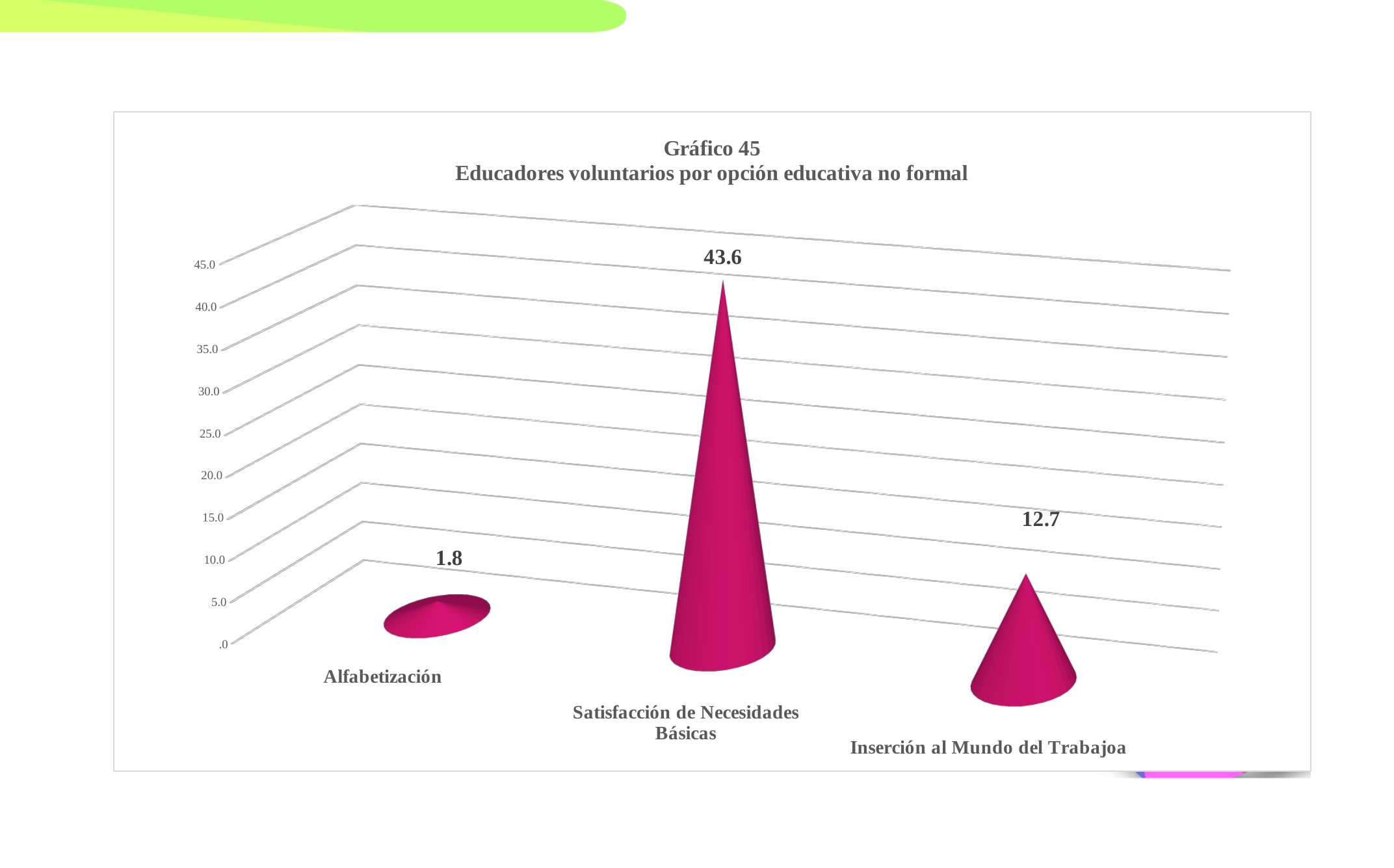
What is the difference between the values for Satisfacción de Necesidades Básicas and Inserción al Mundo del Trabajoa? 30.9 What is the value for Inserción al Mundo del Trabajoa? 12.7 Which category has the lowest value? Alfabetización What is the value for Satisfacción de Necesidades Básicas? 43.6 What is the difference between the values for Inserción al Mundo del Trabajoa and Alfabetización? 10.9 What is the value for Alfabetización? 1.8 What is the title of the chart? Gráfico 45 Educadores voluntarios por opción educativa no formal Is the value for Satisfacción de Necesidades Básicas greater or less than 40.0? greater Which is larger, the value for Inserción al Mundo del Trabajoa or the value for Alfabetización? Inserción al Mundo del Trabajoa How many categories are shown on the chart? 3 What kind of chart is shown on the slide? bar chart Which category has the highest value? Satisfacción de Necesidades Básicas